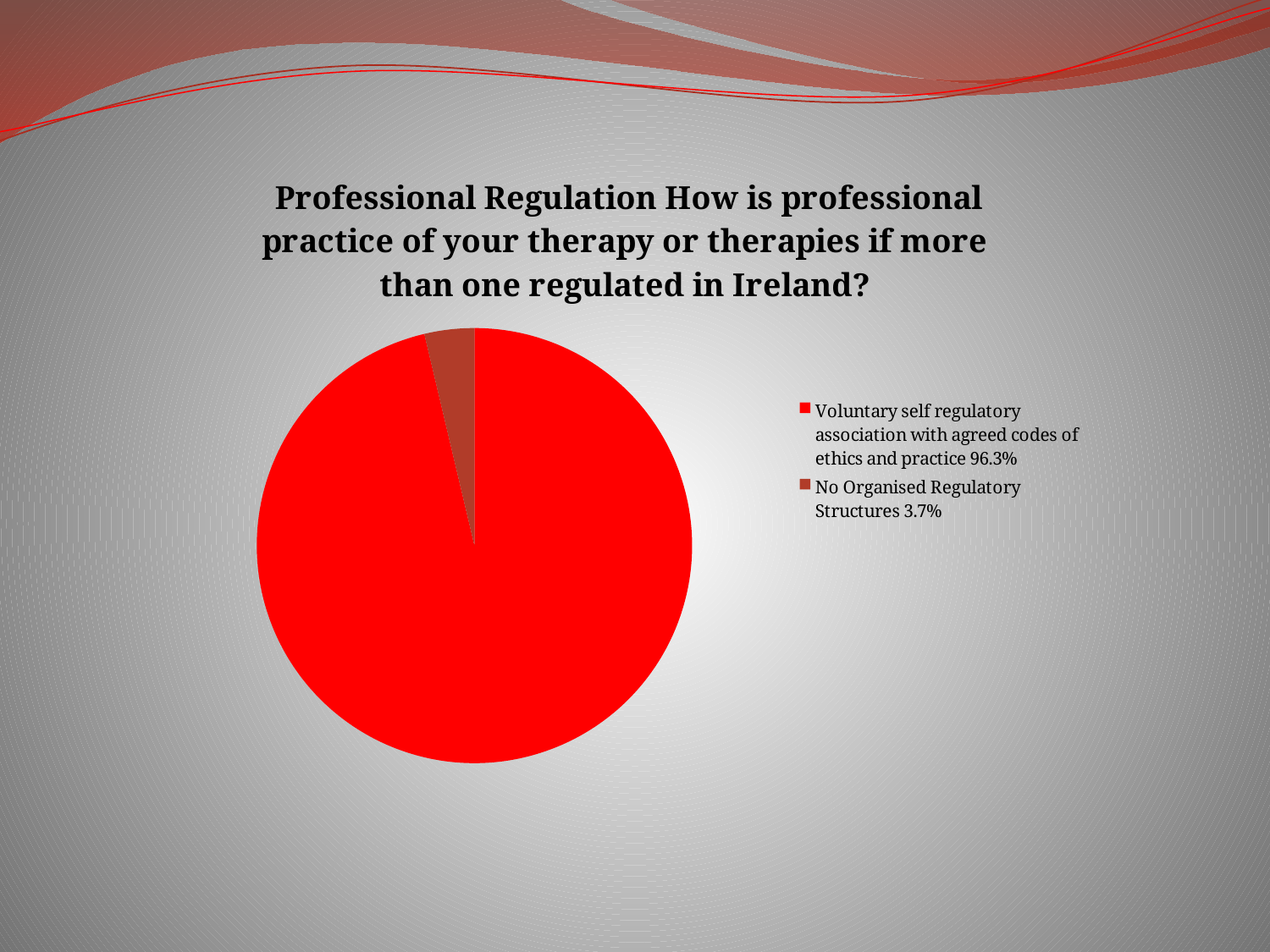
What share of the pie is 'Voluntary self regulatory association with agreed codes of ethics and practice'? 96.3% How many categories does the pie chart show? 2 What share of the pie is 'No Organised Regulatory Structures'? 3.7% What kind of chart is shown on the slide? pie chart What colour is the 'Voluntary self regulatory association' slice? red Which is larger: the 'Voluntary self regulatory association' slice or the 'No Organised Regulatory Structures' slice? Voluntary self regulatory association with agreed codes of ethics and practice Which category has the smallest slice of the pie? No Organised Regulatory Structures What is the difference in percentage points between the 'Voluntary self regulatory association' slice and the 'No Organised Regulatory Structures' slice? 92.6 What is the title of the chart? Professional Regulation How is professional practice of your therapy or therapies if more than one regulated in Ireland? How many entries does the legend list? 2 Which category has the largest slice of the pie? Voluntary self regulatory association with agreed codes of ethics and practice